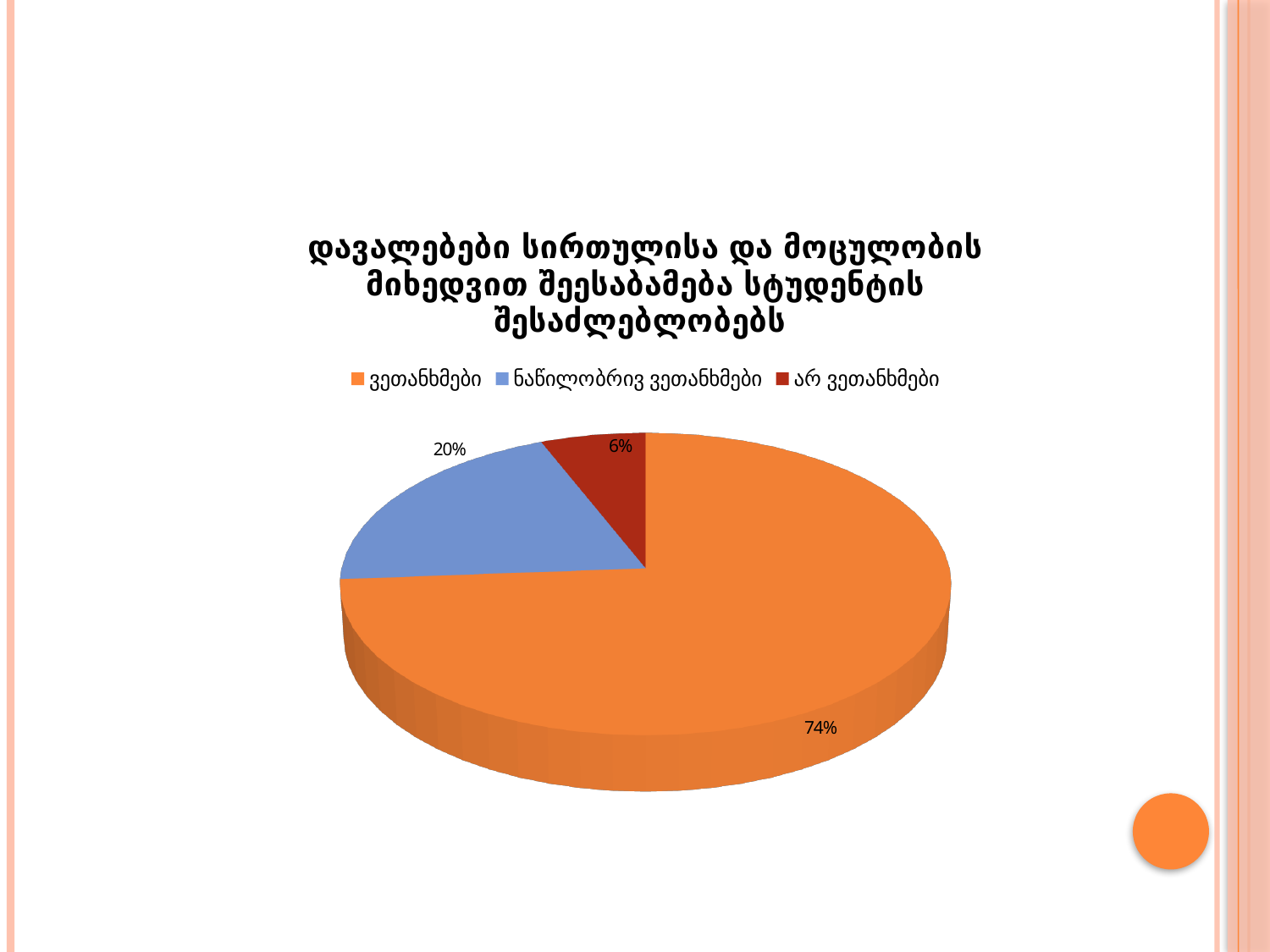
Which category has the smallest share of the pie? არ ვეთანხმები How many entries does the legend list? 3 How many slices does the pie chart have? 3 What percentage is shown for the არ ვეთანხმები slice? 6% What percentage is shown for the ვეთანხმები slice? 74% What kind of chart is shown on the slide? pie chart What colour is the ვეთანხმები slice? orange What is the difference in percentage points between the ნაწილობრივ ვეთანხმები and არ ვეთანხმები slices? 14 What percentage is shown for the ნაწილობრივ ვეთანხმები slice? 20% Which category has the largest share of the pie? ვეთანხმები Which is larger, the ნაწილობრივ ვეთანხმები slice or the არ ვეთანხმები slice? ნაწილობრივ ვეთანხმები What is the difference in percentage points between the ვეთანხმები and ნაწილობრივ ვეთანხმები slices? 54